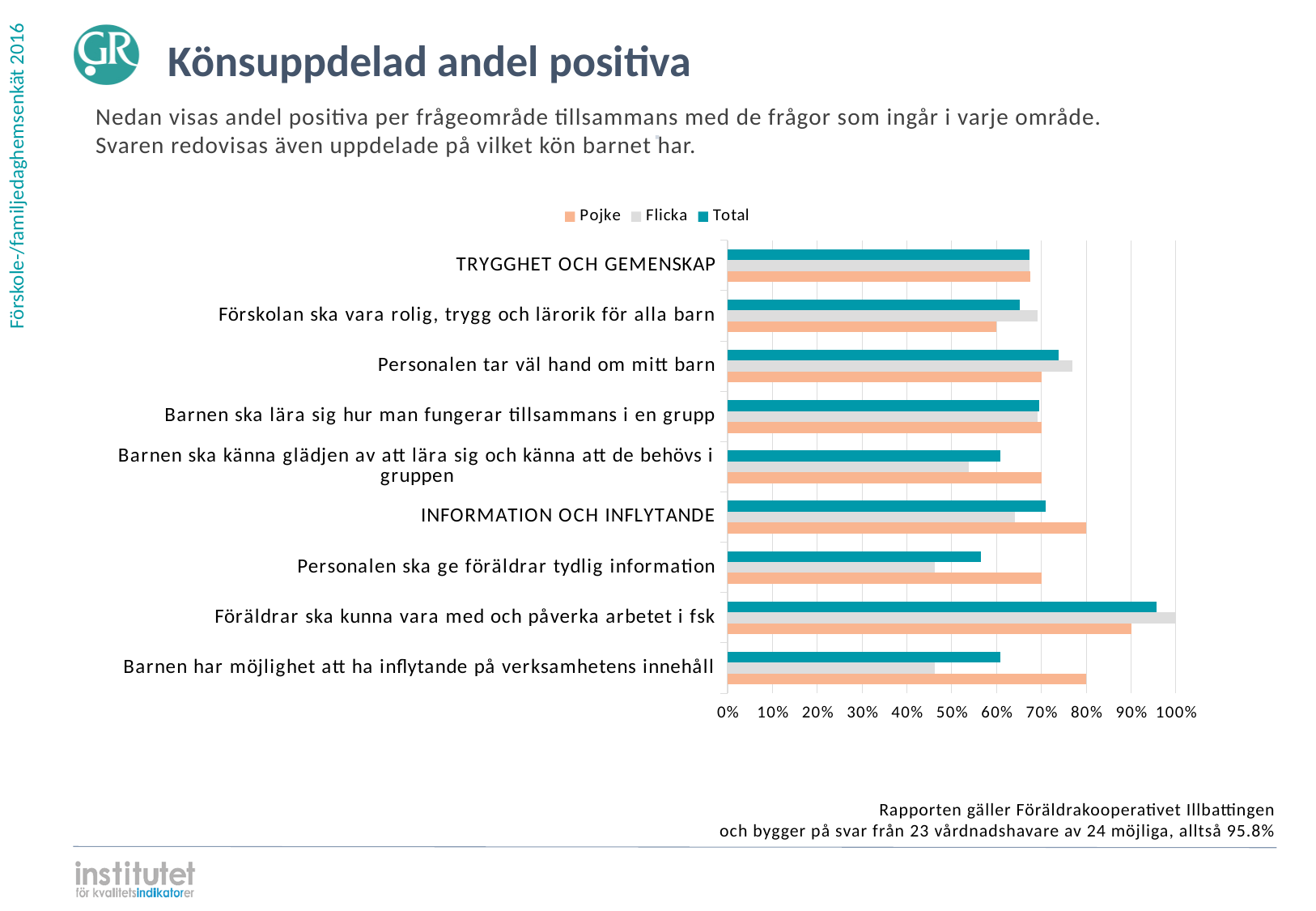
Is the Flicka value for 'Personalen ska ge föräldrar tydlig information' greater or less than 60%? less What are the three series named in the legend? Pojke, Flicka, Total How many series does the legend list? 3 How many categories are plotted on the chart? 9 Is the Total value for 'Föräldrar ska kunna vara med och påverka arbetet i fsk' greater or less than 90%? greater What is the title of the chart slide? Könsuppdelad andel positiva What is the Flicka value for 'Föräldrar ska kunna vara med och påverka arbetet i fsk'? 100% Which category has the highest Flicka value? Föräldrar ska kunna vara med och påverka arbetet i fsk Is the Pojke value for 'Förskolan ska vara rolig, trygg och lärorik för alla barn' greater or less than 70%? less For 'Barnen har möjlighet att ha inflytande på verksamhetens innehåll', which is larger, the Pojke value or the Flicka value? Pojke What kind of chart is shown on the slide? bar chart For 'Personalen tar väl hand om mitt barn', which is larger, the Pojke value or the Flicka value? Flicka